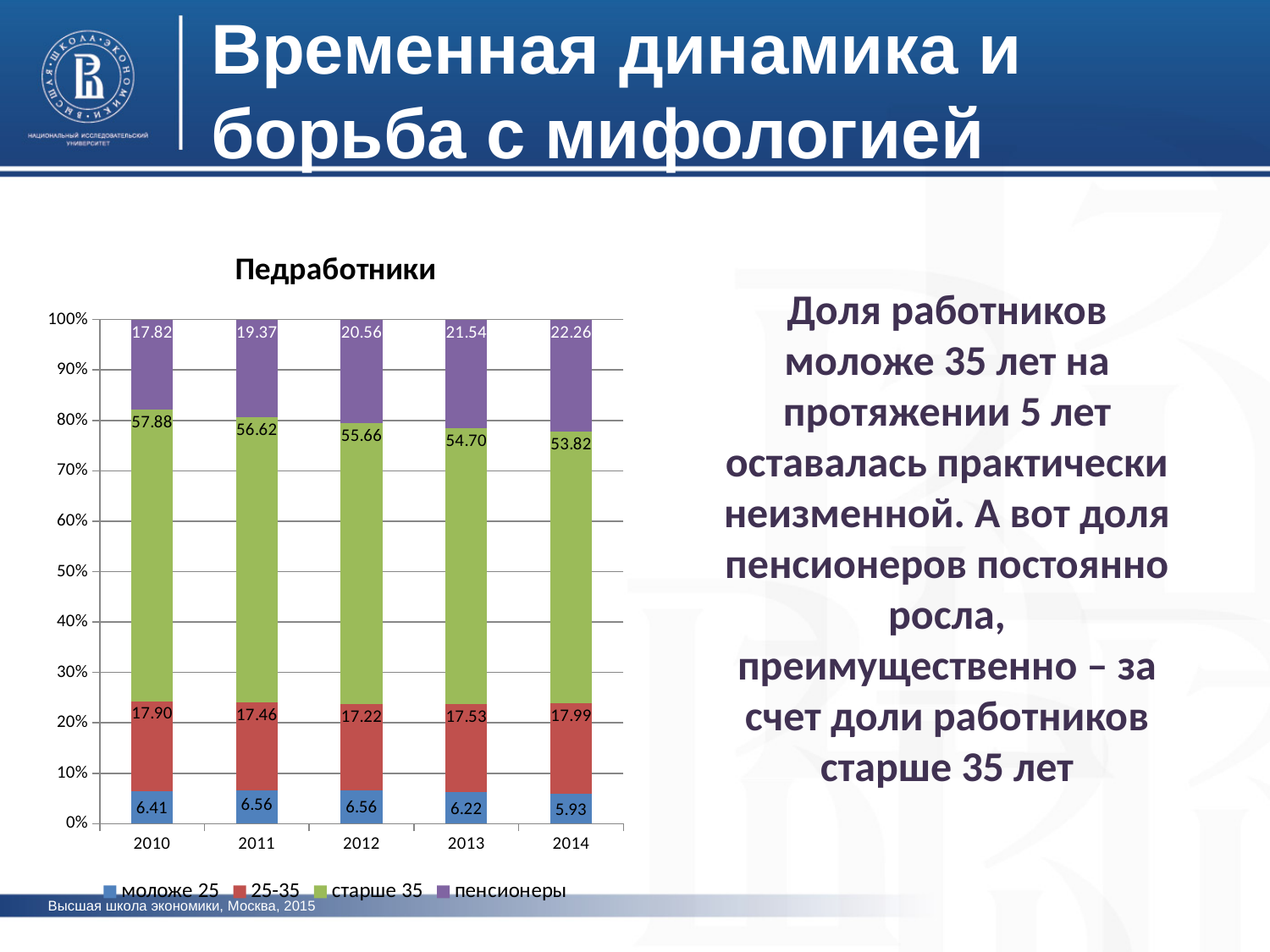
Does the value for пенсионеры rise or fall from 2010 to 2014? Rises What is the difference between the пенсионеры values in 2014 and 2010? 4.44 What is the value for пенсионеры in 2014? 22.26 How many series does the legend list? 4 What is the value for моложе 25 in 2013? 6.22 In which year is the value for пенсионеры highest? 2014 What is the value for старше 35 in 2010? 57.88 What kind of chart is shown? Stacked bar chart What is the value for 25-35 in 2012? 17.22 Which is larger: the 25-35 value in 2010 or in 2011? 2010 How many years are shown on the x axis? 5 In which year is the value for старше 35 lowest? 2014